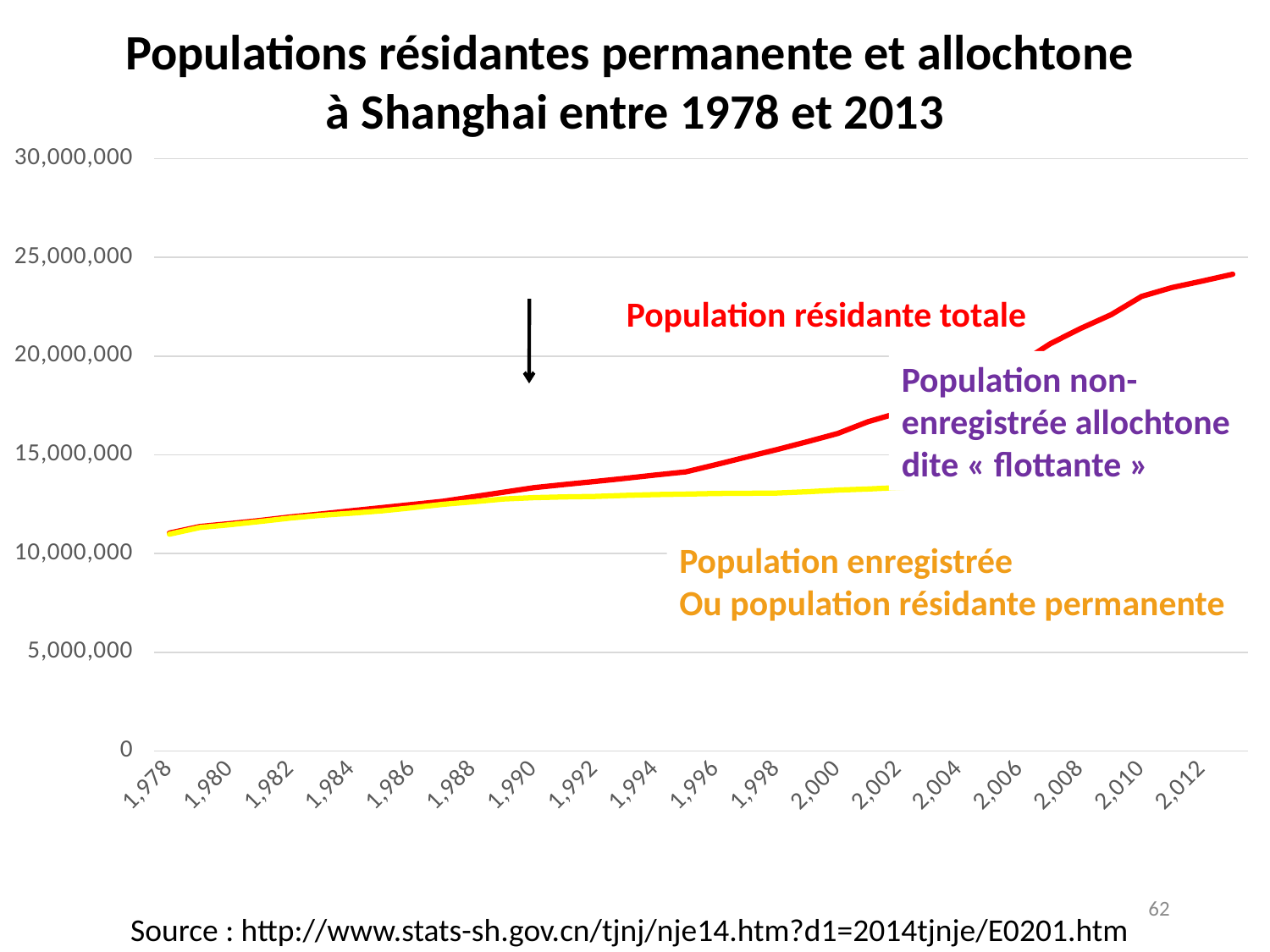
Does the 'Population résidante totale' line rise or fall from 1978 to 2013? rise In which year is the 'Population résidante totale' line at its lowest value? 1978 What colour is the line for 'Population résidante totale'? red How many data series (lines) are plotted on the chart? 2 Is the value of 'Population résidante totale' in 2010 greater or less than 20,000,000? greater What is the title of the chart? Populations résidantes permanente et allochtone à Shanghai entre 1978 et 2013 In 2000, which line is higher: 'Population résidante totale' or 'Population enregistrée'? Population résidante totale Is the value of 'Population enregistrée' in 2002 greater or less than 15,000,000? less Is the value of 'Population résidante totale' in 1978 greater or less than 15,000,000? less In which year does the 'Population résidante totale' line reach its highest value? 2013 What kind of chart is shown on the slide? line chart